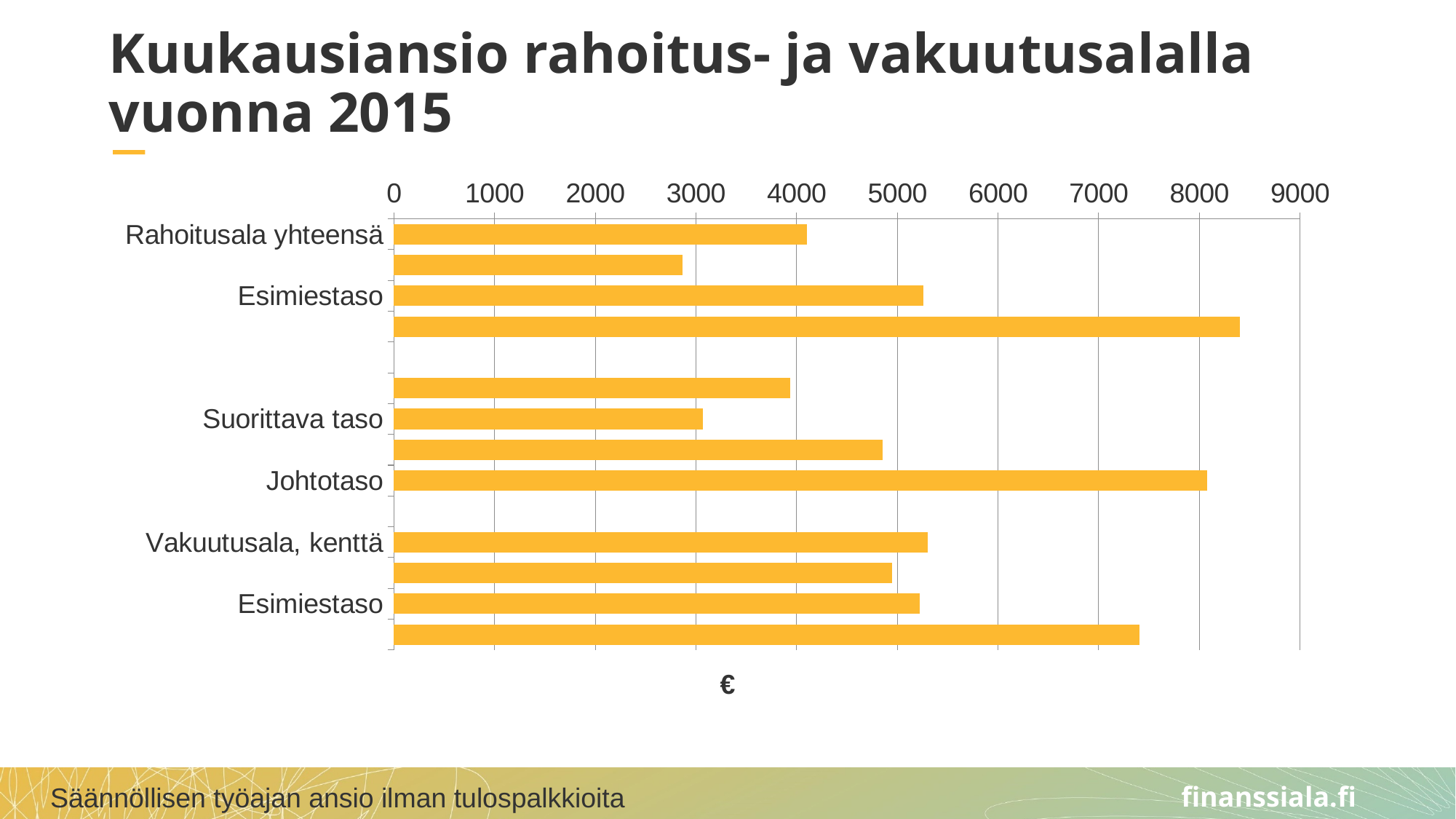
What is the highest tick value shown on the horizontal axis? 9000 What unit is shown on the horizontal axis of the chart? € Is the value for Johtotaso greater or less than 7000? greater Is the value for Suorittava taso greater or less than 4000? less Which is larger, the value for Johtotaso or the value for Suorittava taso? Johtotaso Is the value for Rahoitusala yhteensä greater or less than 5000? less How many bars are plotted in the chart? 12 Which is larger, the value for Vakuutusala, kenttä or the value for Rahoitusala yhteensä? Vakuutusala, kenttä What kind of chart is shown on the slide? bar chart Which labelled category has the longest bar? Johtotaso Which labelled category has the shortest bar? Suorittava taso